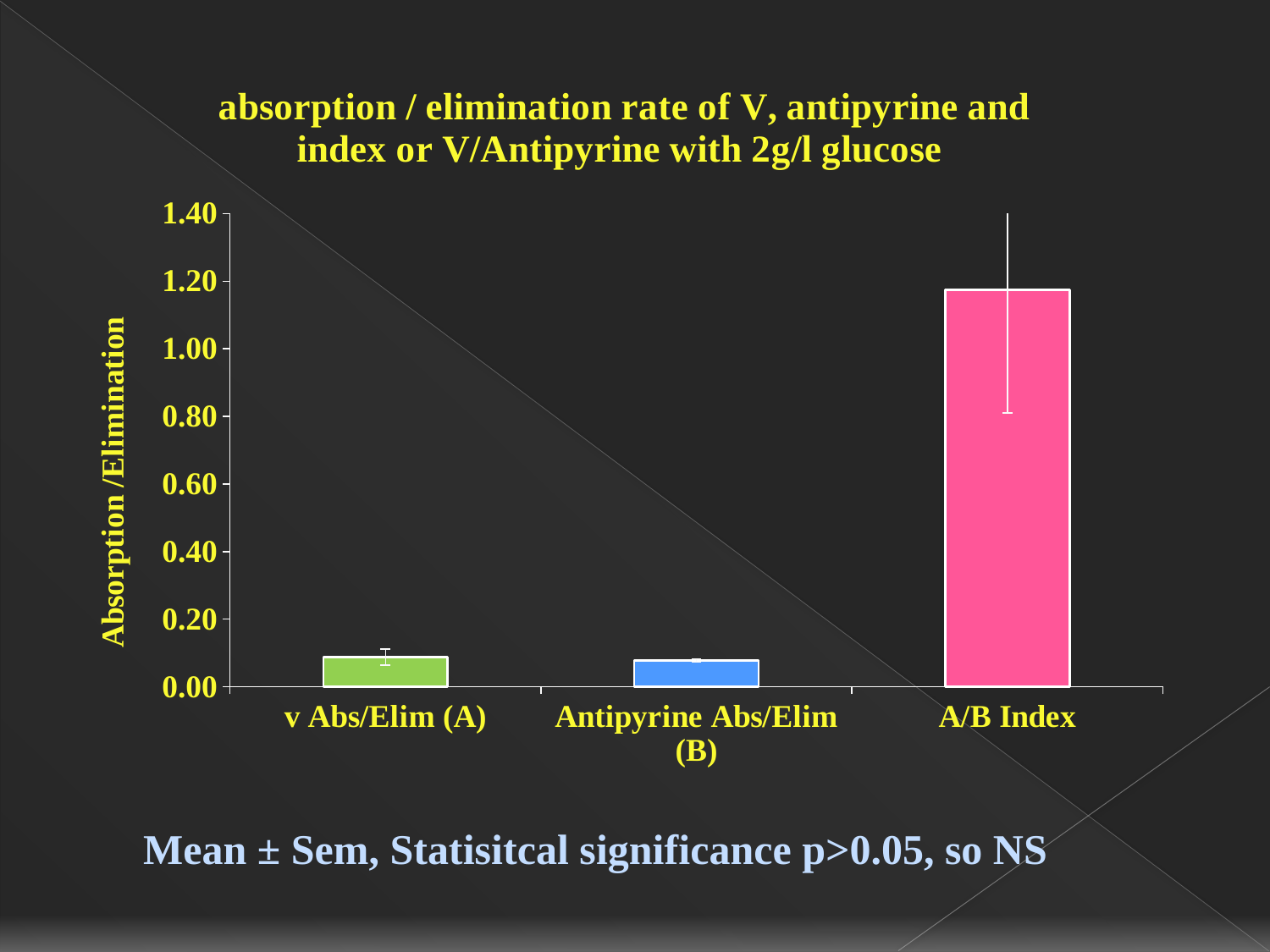
Is the value for Antipyrine Abs/Elim (B) greater or less than 0.20? less Is the value for v Abs/Elim (A) greater or less than 0.40? less How many categories are plotted on the x axis of the chart? 3 Which is larger, the value for A/B Index or the value for v Abs/Elim (A)? A/B Index Which is larger, the value for Antipyrine Abs/Elim (B) or the value for A/B Index? A/B Index Is the value for v Abs/Elim (A) greater or less than 0.20? less What colour is the bar for A/B Index? pink What kind of chart is shown on the slide? bar chart Which category has the highest bar in the chart? A/B Index What is the title of the y axis of the chart? Absorption /Elimination